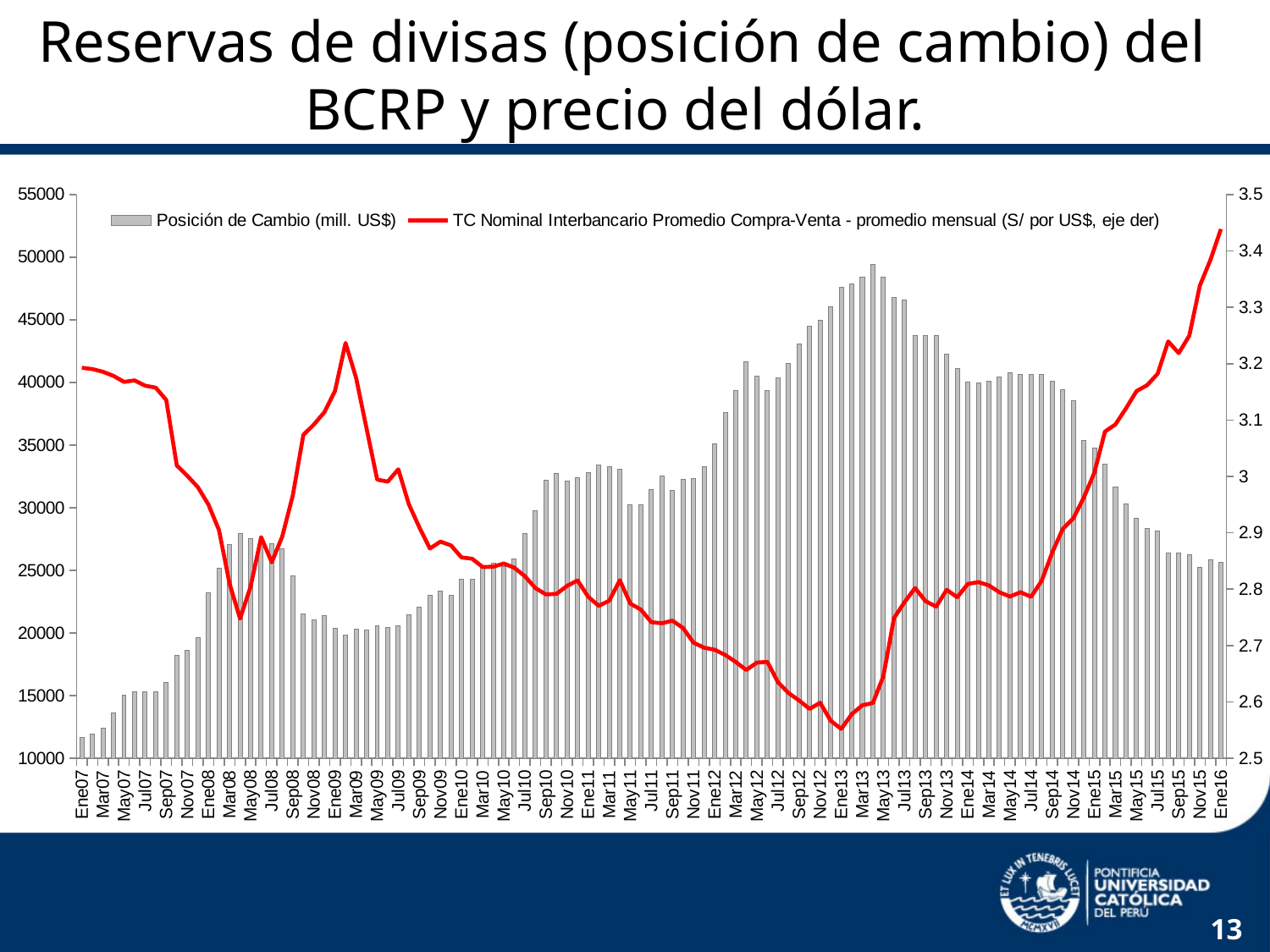
How many series does the legend list? 2 Which series is plotted as bars? Posición de Cambio (mill. US$) In which year do the Posición de Cambio bars reach their highest level? 2013 What kind of chart is shown on the slide? A combined bar and line chart Is the Posición de Cambio value for Ene13 greater or less than 45000? greater Is the Posición de Cambio value for Ene07 greater or less than 15000? less Which is larger, the Posición de Cambio bar for Ene13 or for Ene16? Ene13 Do the Posición de Cambio bars rise or fall from Ene14 to Ene16? fall Is the TC Nominal value for Ene16 greater or less than 3.3? greater In which month does the TC Nominal line reach its highest value? Ene16 In which month is the Posición de Cambio bar lowest? Ene07 What is the maximum value shown on the right-hand axis? 3.5